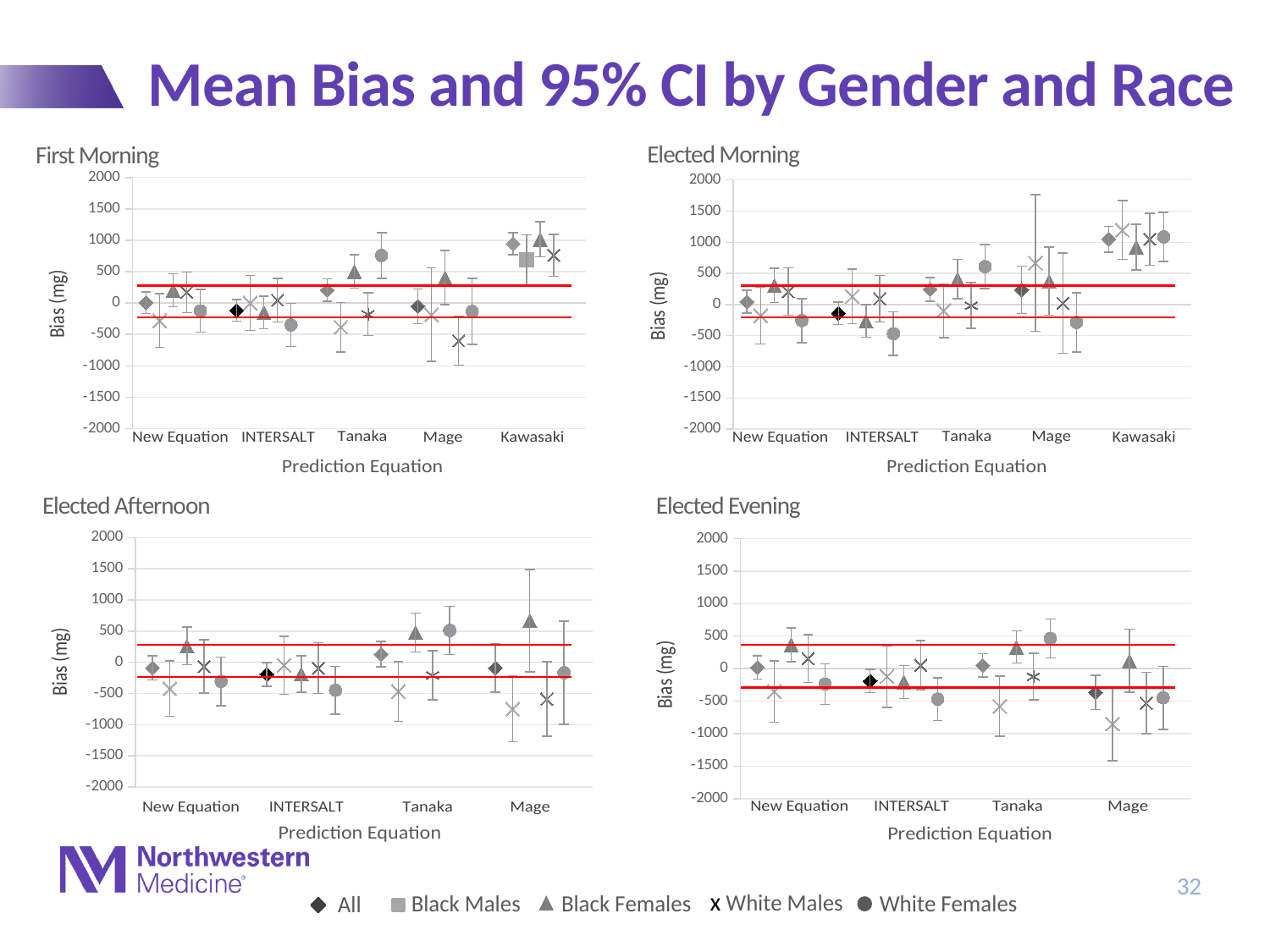
What kind of chart is the First Morning chart? scatter chart with error bars In the Elected Afternoon chart, how many prediction equations are shown on the x axis? 4 What is the label on the y axis of the Elected Evening chart? Bias (mg) How many charts are shown on the slide? 4 In the First Morning chart, which is larger: the All value for Kawasaki or the All value for New Equation? Kawasaki In the Elected Morning chart, which prediction equation has the highest value for the All series? Kawasaki In the First Morning chart, how many prediction equations are shown on the x axis? 5 In the First Morning chart, which prediction equation has the highest value for the All series? Kawasaki In the First Morning chart, is the All value for Kawasaki greater or less than 500? greater How many series does the legend list? 5 In the Elected Afternoon chart, which prediction equation has the highest value for the All series? Tanaka